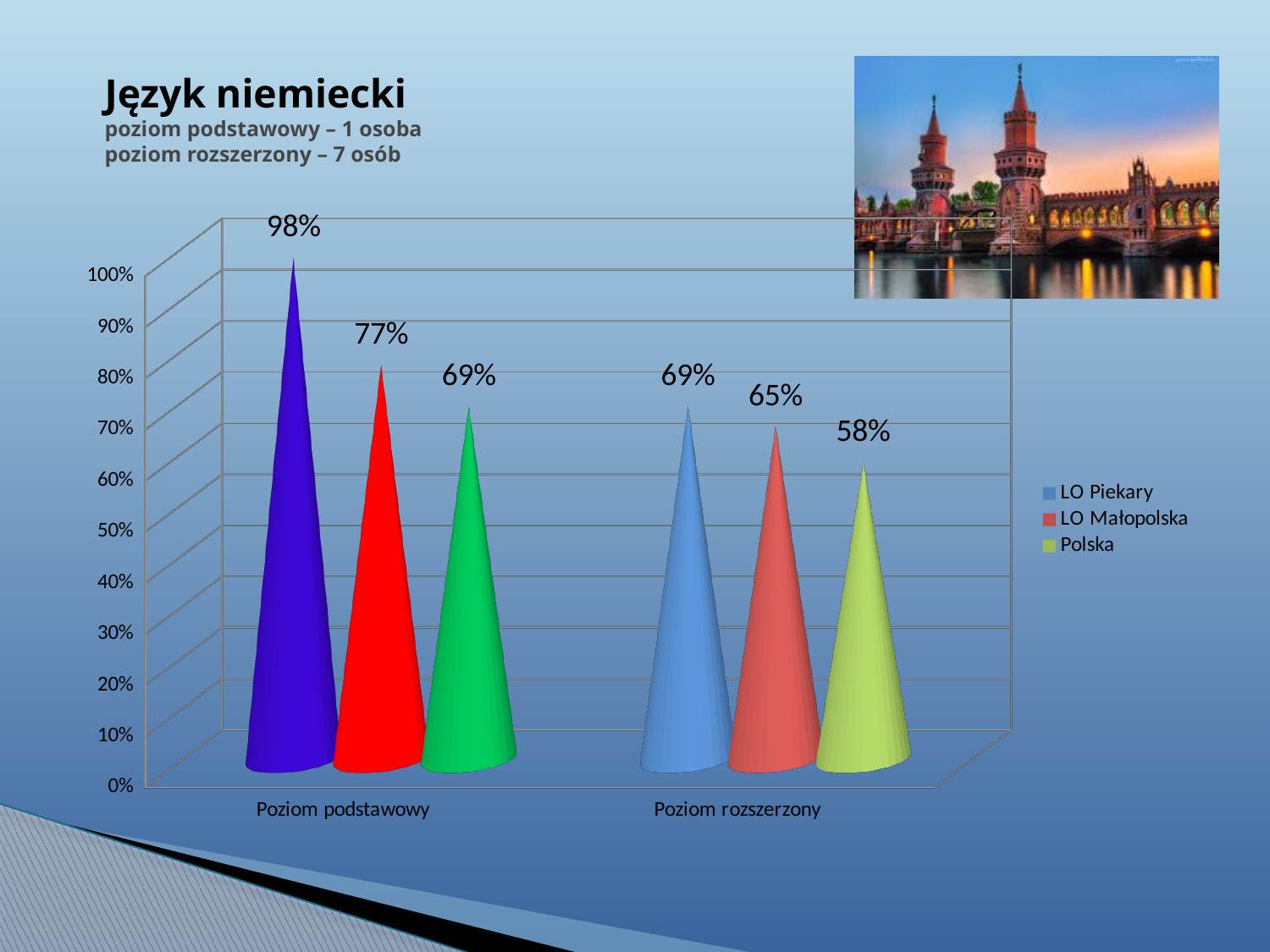
What is the difference between LO Piekary at Poziom podstawowy and LO Piekary at Poziom rozszerzony? 29% Which series has the highest value at Poziom podstawowy? LO Piekary What kind of chart is shown on the slide? Bar chart Which series has the lowest value at Poziom rozszerzony? Polska How many categories are shown on the x axis? 2 What is the value for LO Małopolska at Poziom rozszerzony? 65% How many series does the legend list? 3 What is the value for LO Małopolska at Poziom podstawowy? 77% What is the difference between LO Piekary and Polska at Poziom podstawowy? 29% Which is larger: LO Małopolska at Poziom podstawowy or LO Małopolska at Poziom rozszerzony? Poziom podstawowy What is the value for LO Piekary at Poziom podstawowy? 98% What is the value for Polska at Poziom rozszerzony? 58%